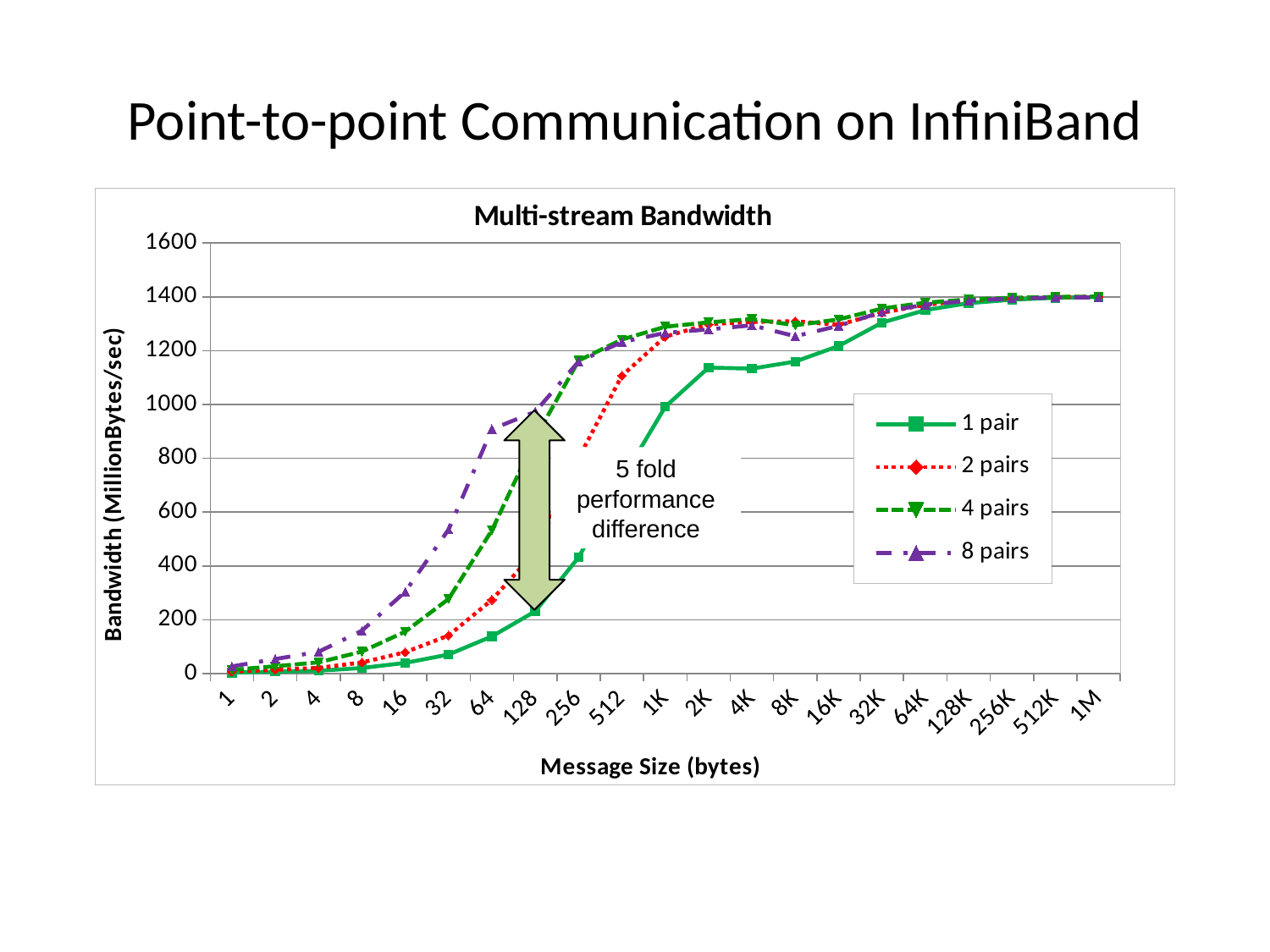
Is the value for 1 pair at message size 128 greater or less than 400? less Is the value for 8 pairs at message size 64 greater or less than 800? greater At message size 64, which series has the higher value, 8 pairs or 1 pair? 8 pairs What is the label of the y axis? Bandwidth (MillionBytes/sec) What kind of chart is shown on the slide? line chart Is the value for 1 pair at message size 2K greater or less than 1000? greater At message size 32, which series has the higher value, 8 pairs or 4 pairs? 8 pairs What is the title of the chart? Multi-stream Bandwidth Which series has the lowest value at message size 64? 1 pair How many series does the legend of the Multi-stream Bandwidth chart list? 4 How many message sizes are marked along the x axis of the chart? 21